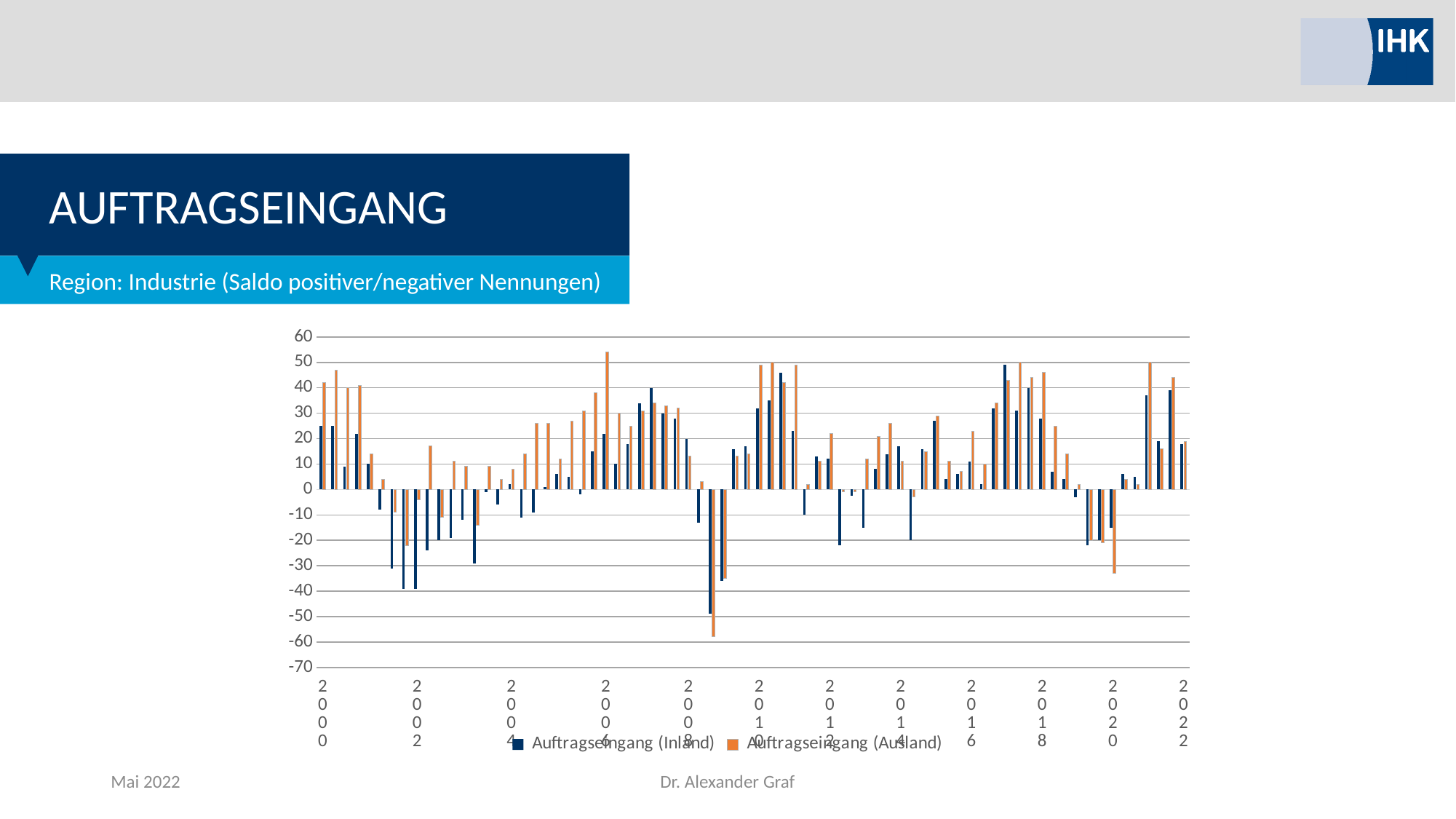
What is the lowest value shown on the vertical axis? -70 Is the Auftragseingang (Ausland) bar at its low point around 2020 greater or less than -20? less Is the highest Auftragseingang (Ausland) bar, around 2007, greater or less than 50? greater Which colour represents the Auftragseingang (Ausland) series? orange Is the lowest Auftragseingang (Inland) bar, around 2009, greater or less than -40? less Around 2009, which series has the lower value: Auftragseingang (Inland) or Auftragseingang (Ausland)? Auftragseingang (Ausland) What kind of chart is shown on the slide? bar chart What are the two series named in the legend? Auftragseingang (Inland) and Auftragseingang (Ausland) How many series does the legend list? 2